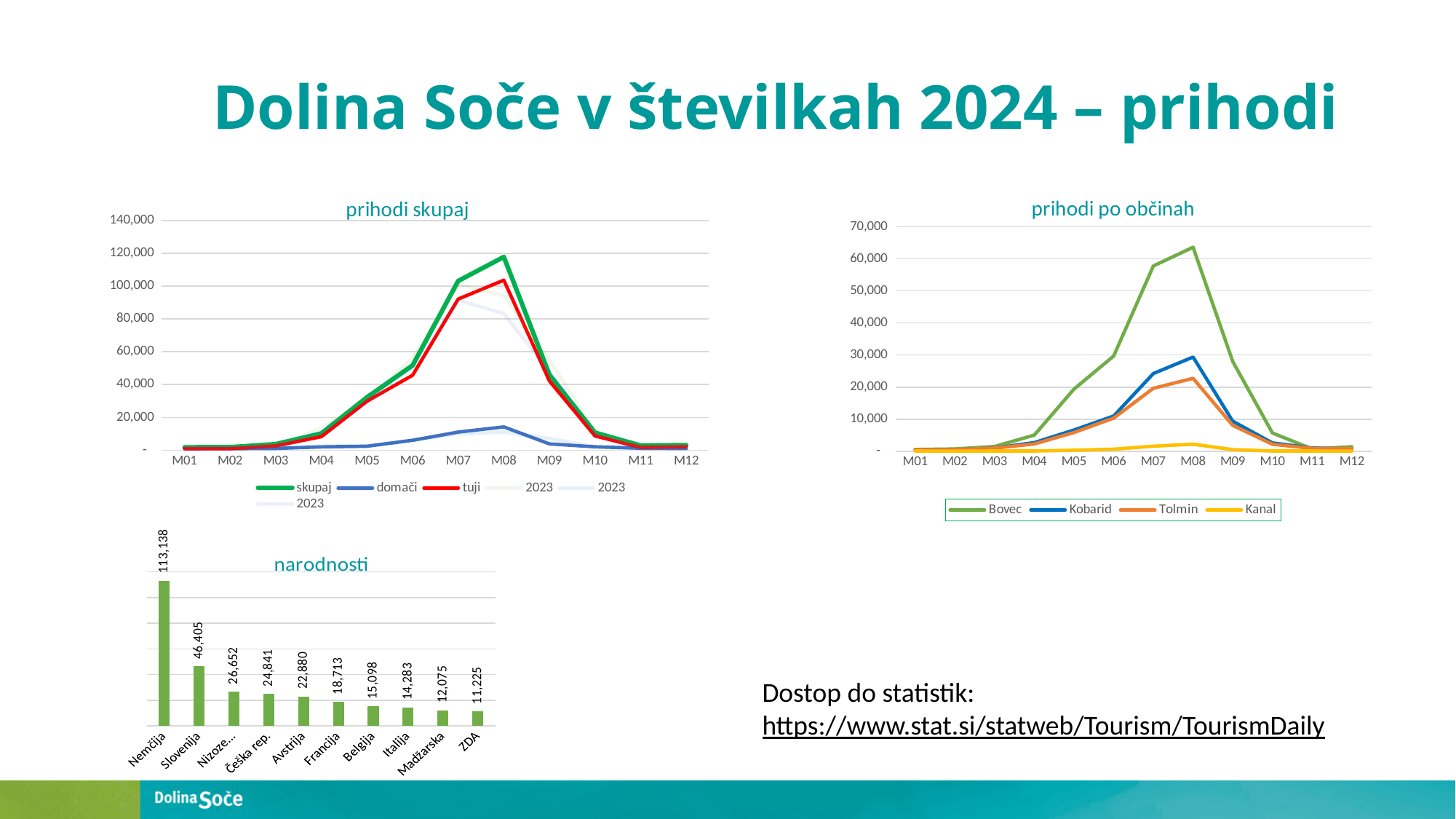
In the 'narodnosti' chart, which category has the highest value? Nemčija In the 'prihodi po občinah' chart, how many series does the legend list? 4 In the 'narodnosti' chart, what is the value for Nemčija? 113,138 In the 'narodnosti' chart, what is the value for Avstrija? 22,880 In the 'prihodi skupaj' chart, is the value for skupaj in M08 greater or less than 100,000? greater In the 'prihodi skupaj' chart, in which month does the skupaj series reach its highest value? M08 In the 'narodnosti' chart, what is the difference between the values for Slovenija and Češka rep.? 21,564 In the 'prihodi po občinah' chart, is the value for Bovec in M08 greater or less than 60,000? greater What kind of chart is the 'narodnosti' chart? bar chart In the 'narodnosti' chart, which category has the lowest value? ZDA In the 'narodnosti' chart, how many categories are shown? 10 In the 'prihodi po občinah' chart, which municipality has the highest value in M08? Bovec